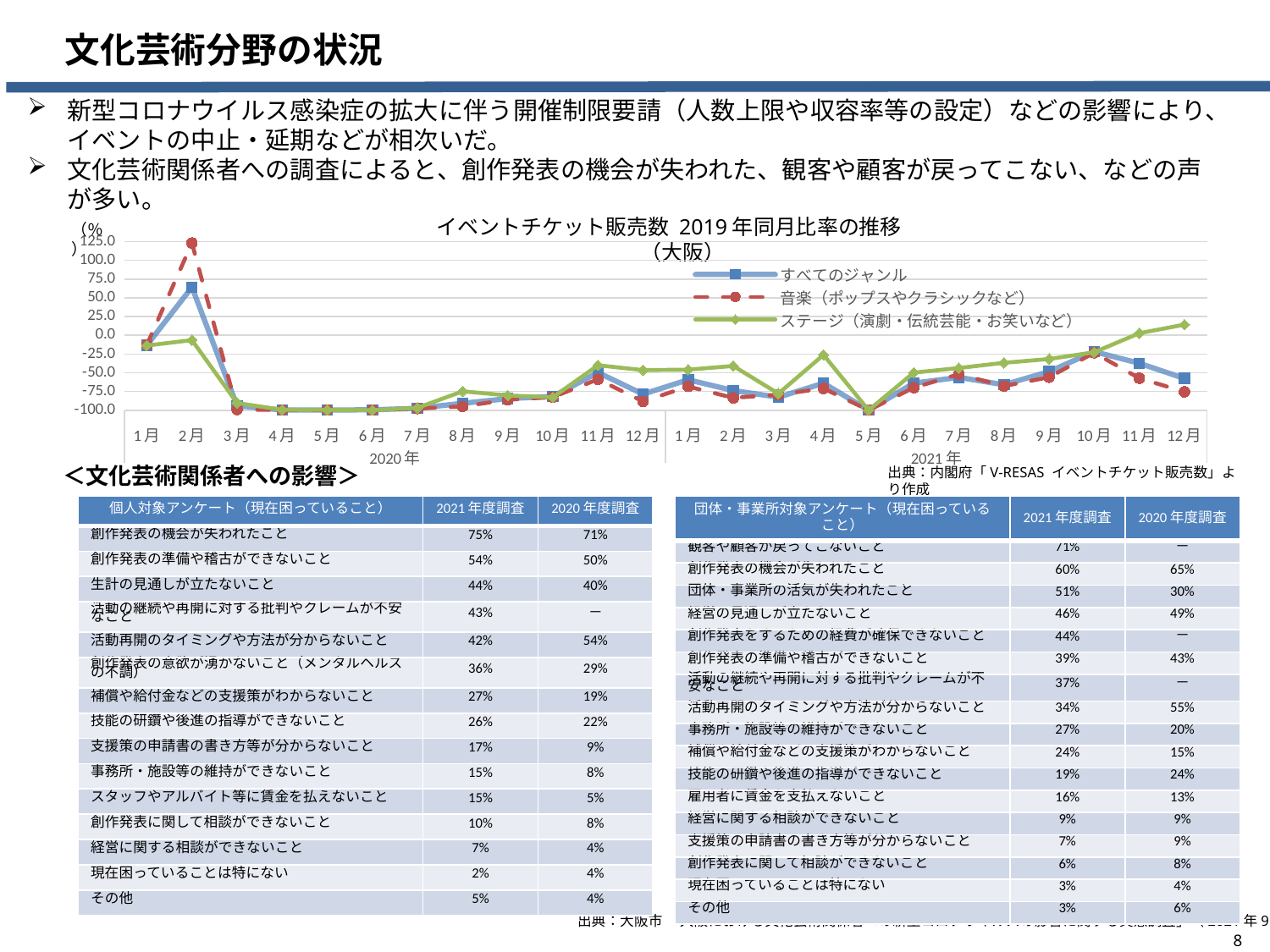
Is the value for 音楽 in 2月 2020年 greater or less than 100.0? greater How many monthly data points are plotted along the x axis of the chart? 24 Which series has the highest value in 12月 2021年? ステージ（演劇・伝統芸能・お笑いなど） Is the value for すべてのジャンル in 2月 2020年 greater or less than 50.0? greater What is the title of the chart? イベントチケット販売数 2019年同月比率の推移（大阪） Does the ステージ series rise or fall from 5月 2021年 to 12月 2021年? rise Which series in the chart is drawn with a dashed red line? 音楽（ポップスやクラシックなど） What kind of chart is shown on the slide? line chart Is the value for ステージ in 12月 2021年 greater or less than 0.0? greater In which month does the 音楽 series reach its highest value? 2月 2020年 How many series does the chart legend list? 3